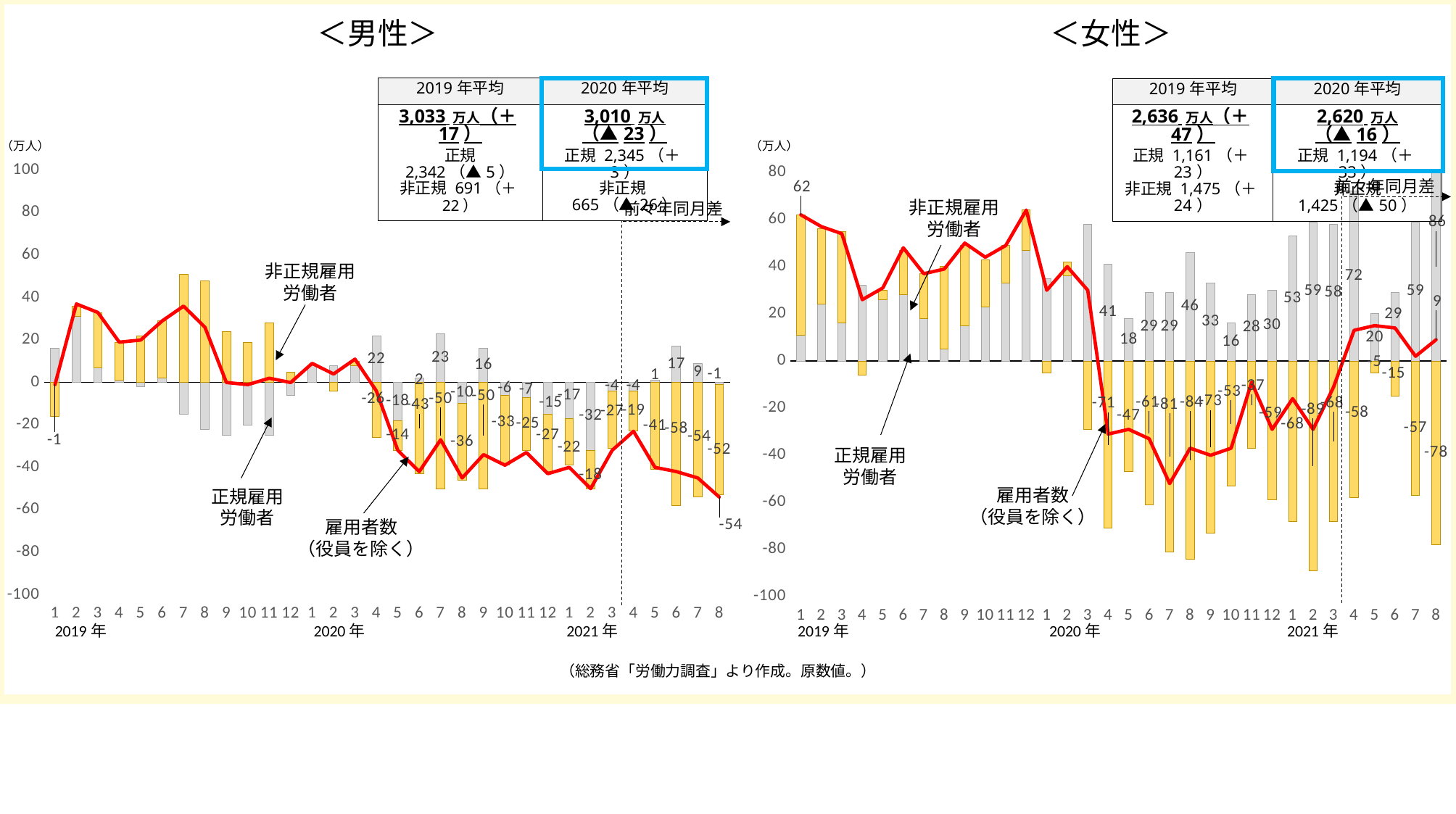
On the ＜男性＞ chart, what is the value of the red 雇用者数（役員を除く） line at 2021年8月? -54 On the ＜男性＞ chart, what is the 2020年平均 number of employees shown in the summary box? 3,010 万人 On the ＜女性＞ chart, what is the 2020年平均 number of employees shown in the summary box? 2,620 万人 On the ＜女性＞ chart, what is the value of the red 雇用者数（役員を除く） line at 2019年1月? 62 On the ＜男性＞ chart, what is the value of the red 雇用者数（役員を除く） line at 2019年1月? -1 On the ＜男性＞ chart, what kind of chart is used to show the data? bar and line chart On the ＜女性＞ chart, what is the value of the grey 正規雇用労働者 bar at 2020年4月? 41 On the ＜男性＞ chart, what is the 2019年平均 number of employees shown in the summary box? 3,033 万人 On the ＜女性＞ chart, what is the 2019年平均 number of employees shown in the summary box? 2,636 万人 On the ＜女性＞ chart, is the yellow 非正規雇用労働者 bar at 2021年2月 greater or less than -80? less On the ＜女性＞ chart, which is larger, the 2019年平均 or the 2020年平均 employee total? 2019年平均 On the ＜男性＞ chart, what is the difference between the 2019年平均 and 2020年平均 employee totals in the summary boxes? 23 万人